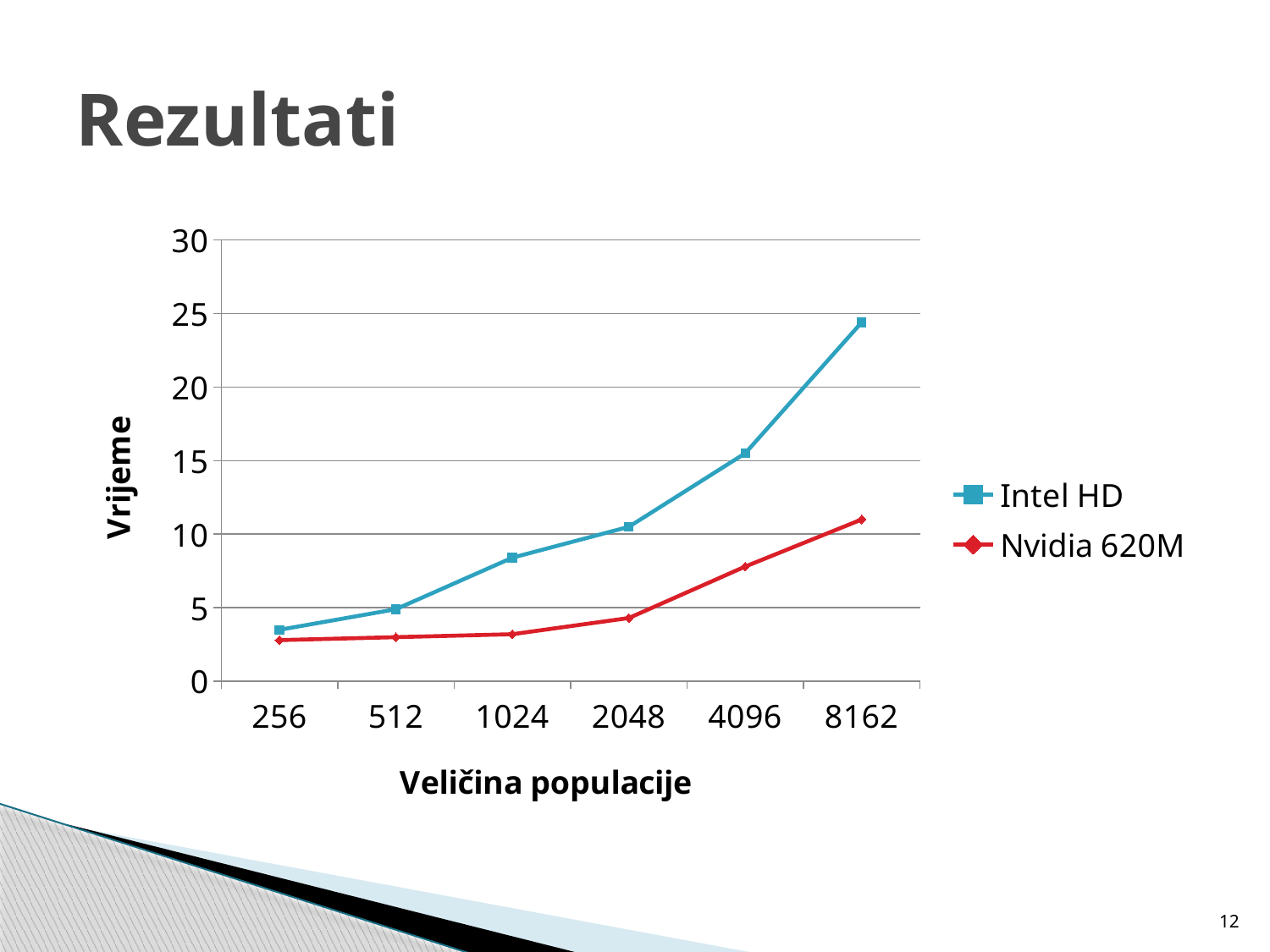
Is the value for Intel HD at population size 8162 greater or less than 20? greater Do the values for Nvidia 620M rise or fall as population size increases? rise Is the value for Intel HD at population size 256 greater or less than 5? less What kind of chart is shown on the slide? line chart Is the value for Nvidia 620M at population size 2048 greater or less than 5? less At population size 8162, which series has the higher value, Intel HD or Nvidia 620M? Intel HD How many population sizes are plotted along the x axis? 6 What is the title of the x axis? Veličina populacije How many series does the legend list? 2 At which population size does Intel HD reach its highest value? 8162